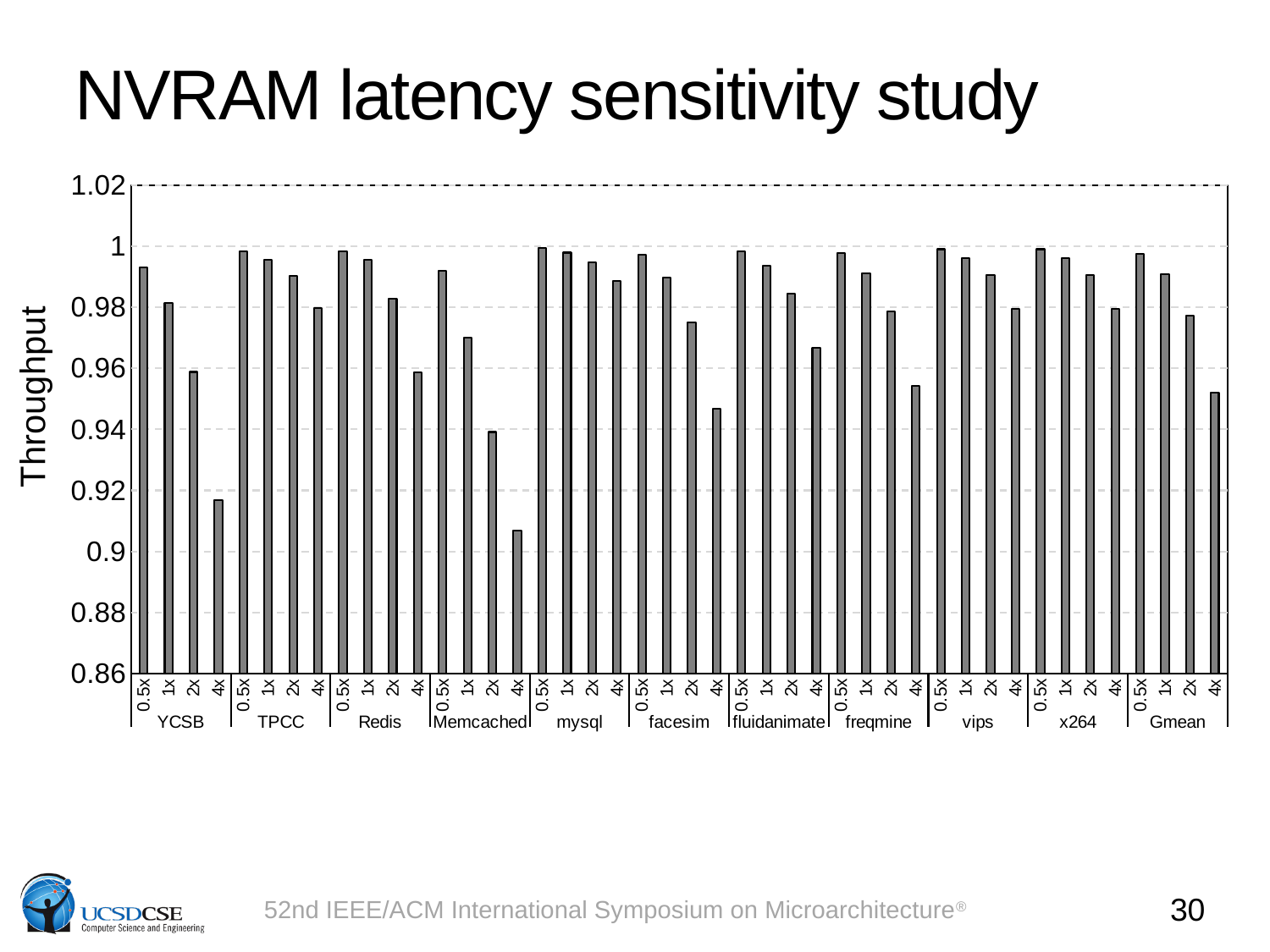
Is the throughput for Memcached at 4x greater or less than 0.92? less Within each benchmark group, does throughput rise or fall as the latency multiplier increases from 0.5x to 4x? fall Which latency setting gives the lowest throughput within every benchmark group? 4x How many benchmark groups are shown along the x axis of the chart? 11 What kind of chart is shown on the slide? bar chart Is the throughput for YCSB at 4x greater or less than 0.9? greater Which is larger, the throughput for YCSB at 4x or for Memcached at 4x? YCSB at 4x How many bars are plotted for each benchmark group? 4 Which benchmark contains the lowest bar in the chart? Memcached Is the throughput for Gmean at 4x greater or less than 0.94? greater What is the label of the y axis? Throughput